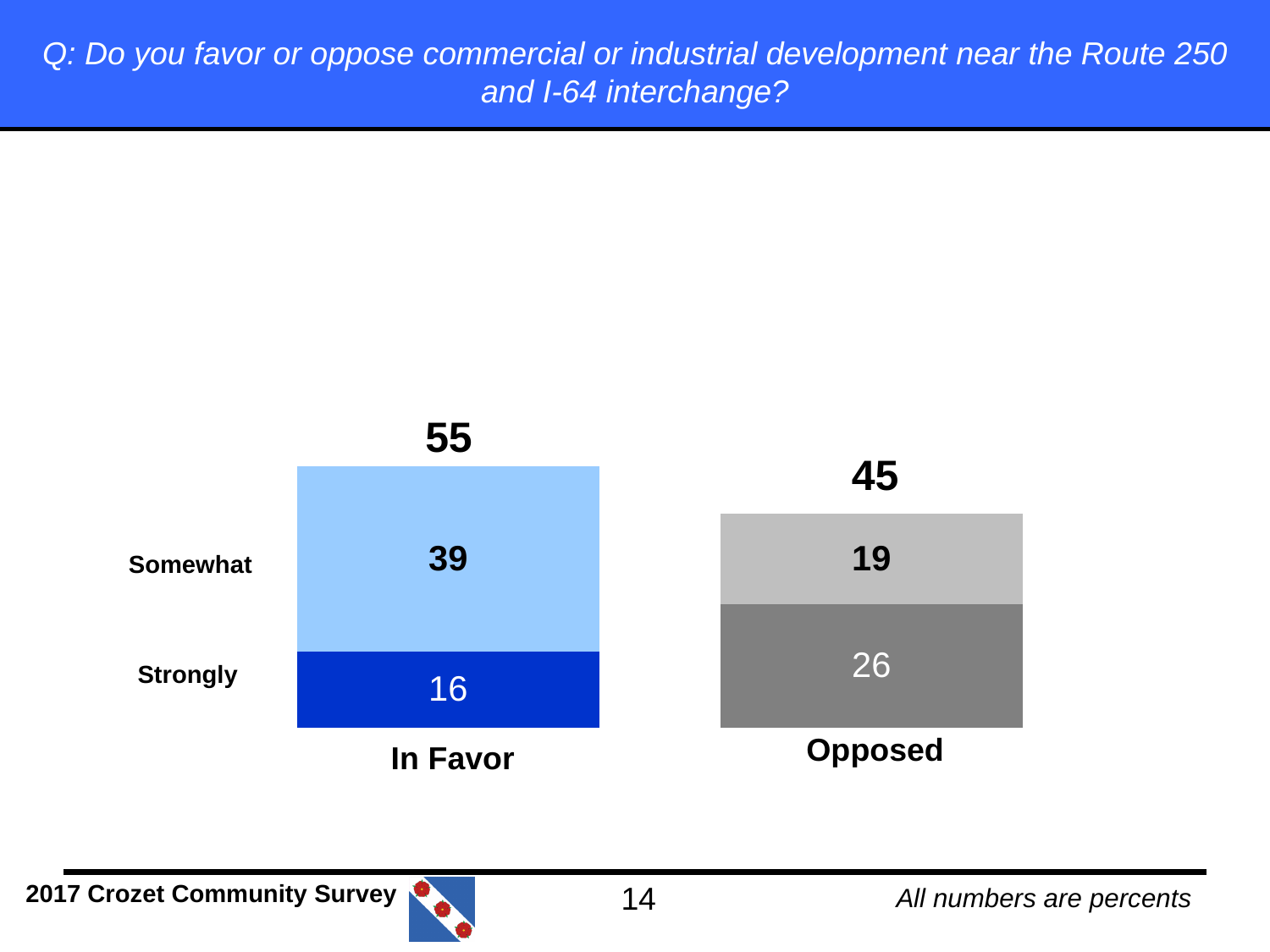
How many categories are shown on the x axis? 2 What is the Strongly value for Opposed? 26 What is the question shown in the title of the slide? Do you favor or oppose commercial or industrial development near the Route 250 and I-64 interchange? What kind of chart is shown on the slide? Stacked bar chart What is the Strongly value for In Favor? 16 What is the Somewhat value for In Favor? 39 What is the difference between the Strongly values for Opposed and In Favor? 10 What is the total for the In Favor bar? 55 What is the total for the Opposed bar? 45 What is the Somewhat value for Opposed? 19 What is the difference between the In Favor total and the Opposed total? 10 Which category has the higher total, In Favor or Opposed? In Favor